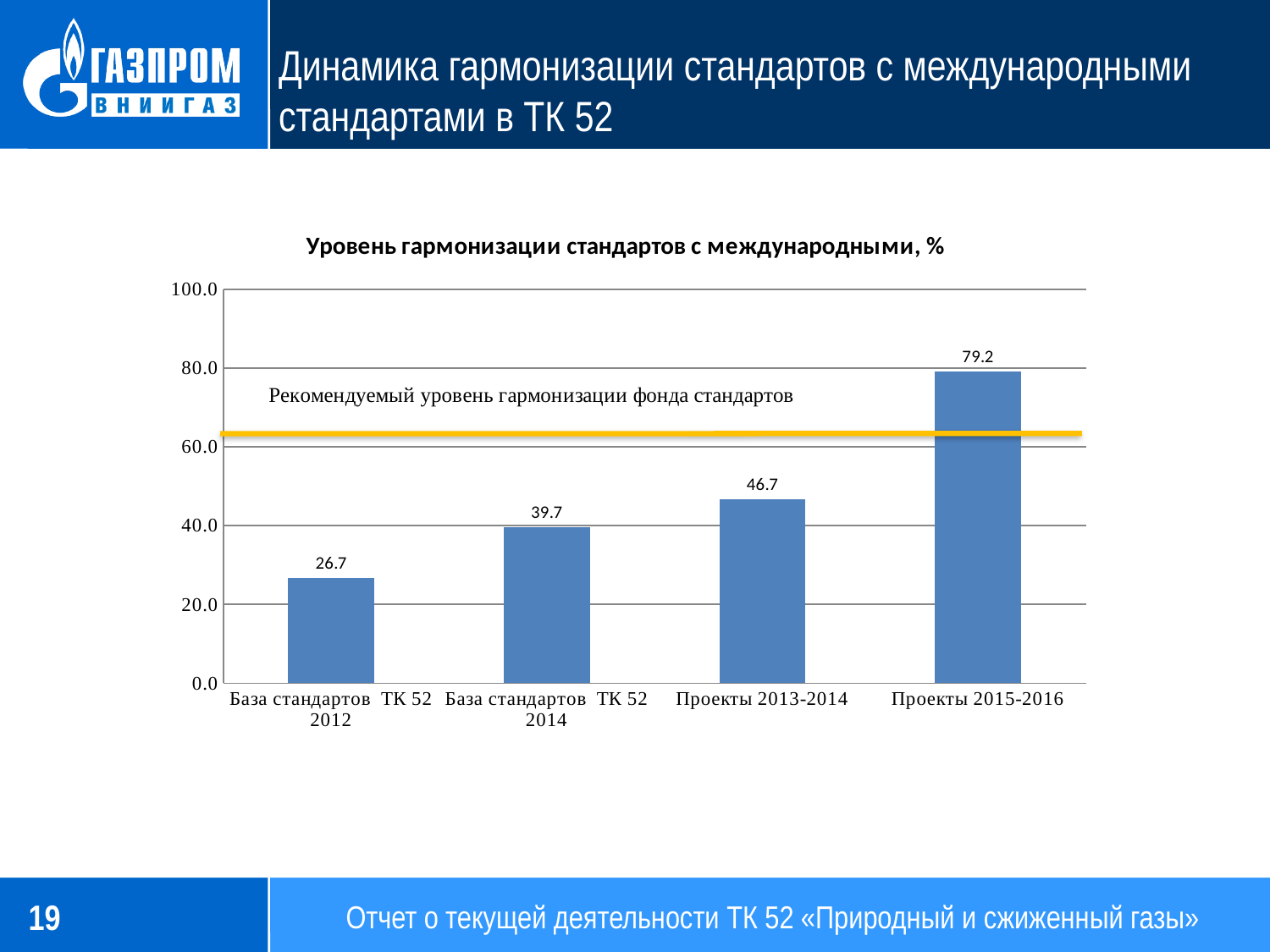
Do the values rise or fall from left to right along the x axis? rise Is the value for Проекты 2015-2016 greater or less than 60.0? greater What kind of chart is shown on the slide? bar chart How many categories are shown on the x axis? 4 What is the value for Проекты 2015-2016? 79.2 Which category has the highest value? Проекты 2015-2016 What is the difference between the values for База стандартов ТК 52 2014 and База стандартов ТК 52 2012? 13.0 Which category has the lowest value? База стандартов ТК 52 2012 What is the value for База стандартов ТК 52 2012? 26.7 What is the value for Проекты 2013-2014? 46.7 What is the difference between the values for Проекты 2015-2016 and Проекты 2013-2014? 32.5 Which is larger, the value for База стандартов ТК 52 2014 or the value for Проекты 2013-2014? Проекты 2013-2014